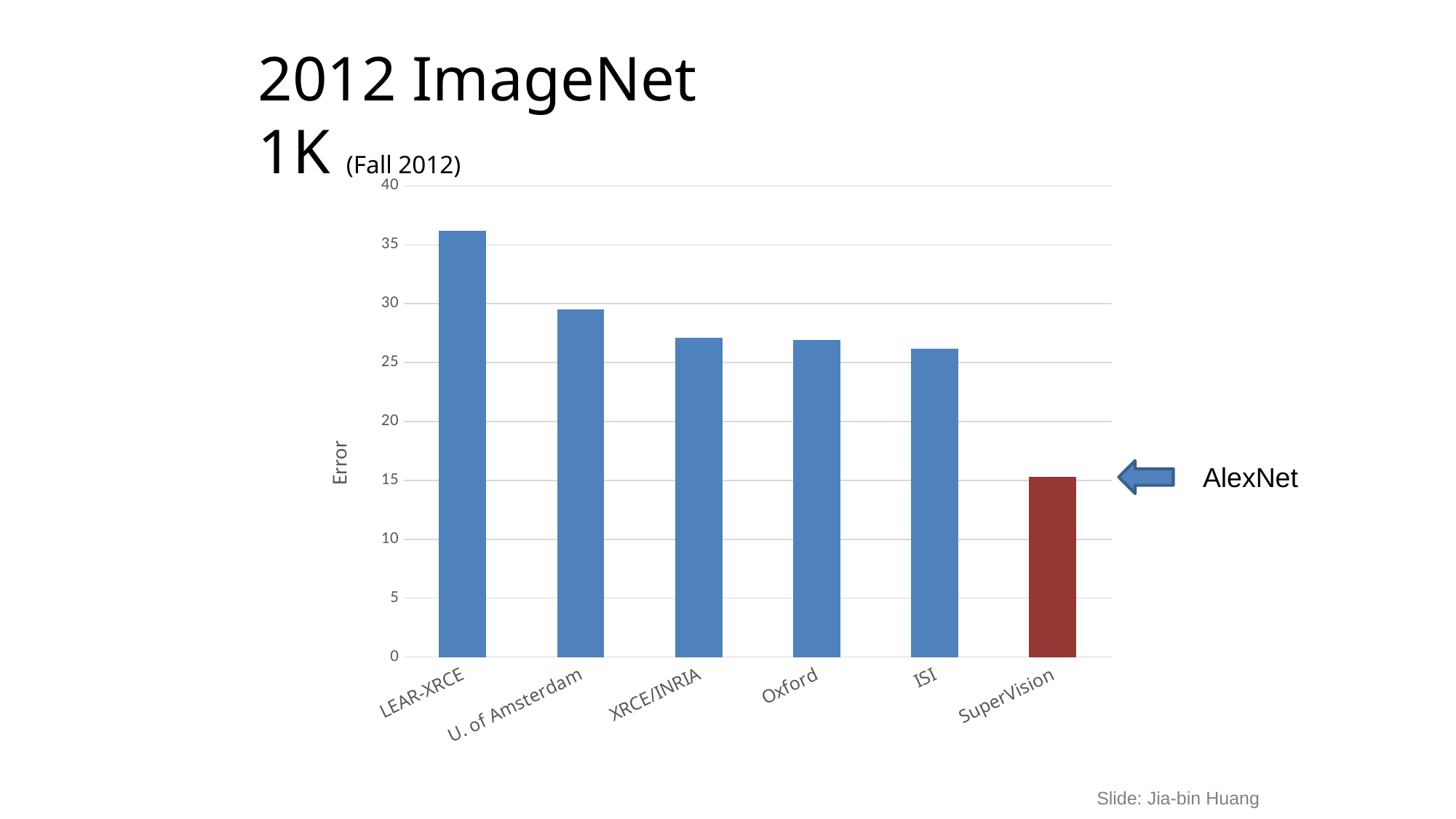
Which team's bar is labelled with the arrow annotation 'AlexNet'? SuperVision Which has a lower error, ISI or SuperVision? SuperVision Is the error for U. of Amsterdam greater or less than 25? greater Which team has the lowest error? SuperVision Which has a higher error, LEAR-XRCE or U. of Amsterdam? LEAR-XRCE How many categories (teams) are plotted on the x axis? 6 Do the error values rise or fall moving from left to right along the x axis? fall What kind of chart is shown on the slide? bar chart Is the error for LEAR-XRCE greater or less than 35? greater Is the error for ISI greater or less than 30? less Which team has the highest error? LEAR-XRCE